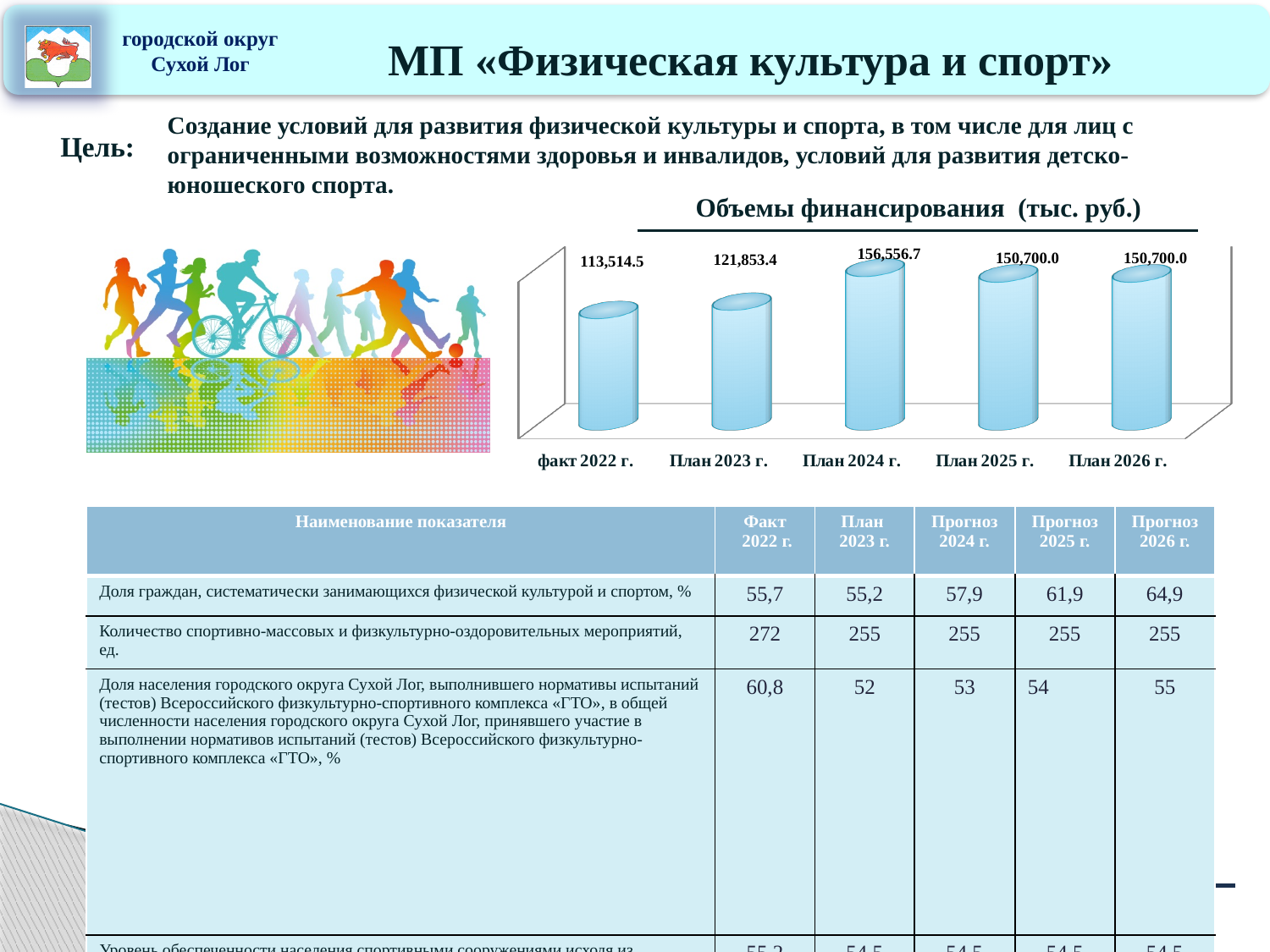
What is the value for факт 2022 г. in the Объемы финансирования chart? 113,514.5 What is the difference between the values for План 2024 г. and План 2025 г. in the Объемы финансирования chart? 5,856.7 In the Объемы финансирования chart, which is larger: the value for План 2023 г. or the value for План 2025 г.? План 2025 г. How many categories are shown in the Объемы финансирования chart? 5 Which category has the lowest value in the Объемы финансирования chart? факт 2022 г. What is the value for План 2024 г. in the Объемы финансирования chart? 156,556.7 What is the value for План 2026 г. in the Объемы финансирования chart? 150,700.0 What is the value for План 2023 г. in the Объемы финансирования chart? 121,853.4 Which category has the highest value in the Объемы финансирования chart? План 2024 г. What is the difference between the values for План 2023 г. and факт 2022 г. in the Объемы финансирования chart? 8,338.9 What unit is given in the title of the Объемы финансирования chart? тыс. руб. What kind of chart is the Объемы финансирования chart? bar chart